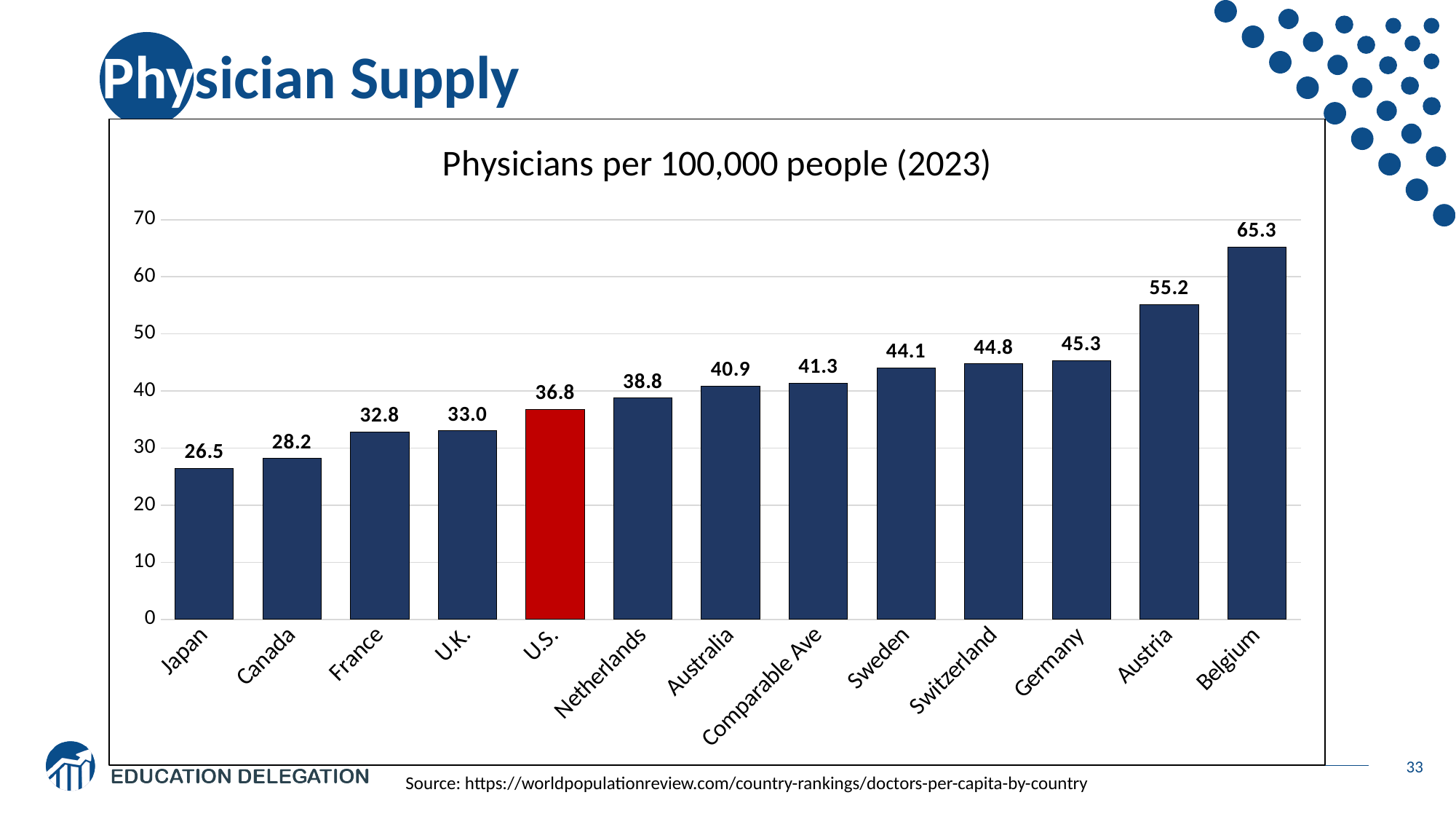
What is the difference between Belgium's value and the U.S. value? 28.5 Which has a higher value, Canada or France? France Is the value for Austria greater or less than 50? greater What is the value for Germany in the chart? 45.3 What is the value for the U.S. in the Physicians per 100,000 people (2023) chart? 36.8 Which country has the lowest number of physicians per 100,000 people? Japan What is the difference between the Comparable Ave and the U.S. value? 4.5 How many categories are shown on the x axis of the chart? 13 What kind of chart is shown on the slide? Bar chart Which country has the highest number of physicians per 100,000 people? Belgium Which bar in the chart is coloured red rather than dark blue? U.S. What is the value for Comparable Ave in the chart? 41.3